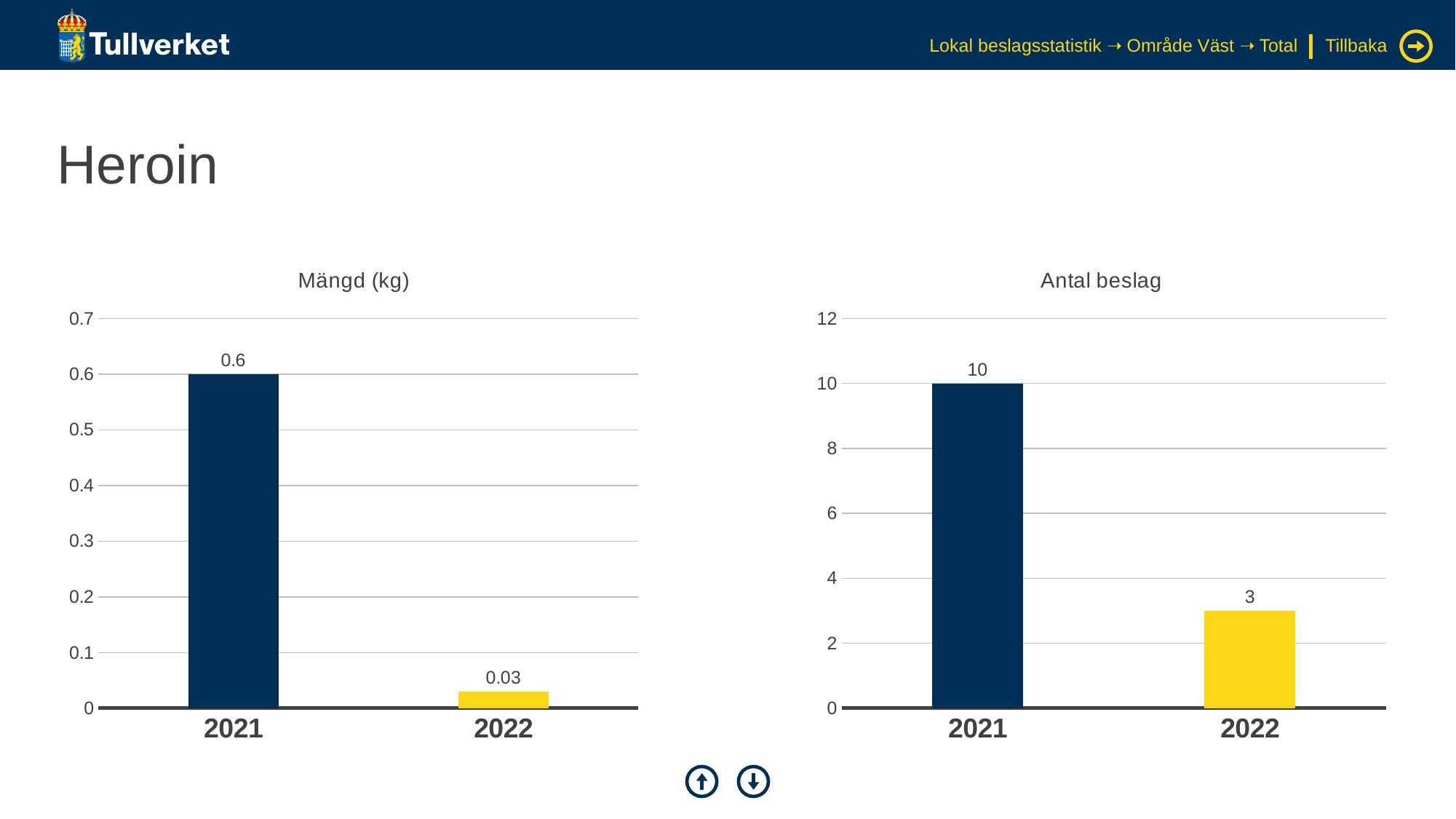
In the 'Antal beslag' chart, what is the value for 2022? 3 In the 'Mängd (kg)' chart, what is the difference between the 2021 and 2022 values? 0.57 In the 'Mängd (kg)' chart, what is the value for 2022? 0.03 In the 'Mängd (kg)' chart, is the value for 2021 larger or smaller than the value for 2022? larger In the 'Antal beslag' chart, which year has the highest value? 2021 In the 'Antal beslag' chart, do the values rise or fall from 2021 to 2022? fall In the 'Antal beslag' chart, what is the difference between the 2021 and 2022 values? 7 In the 'Mängd (kg)' chart, which year has the lowest value? 2022 What kind of chart is the 'Mängd (kg)' chart? bar chart In the 'Mängd (kg)' chart, what is the value for 2021? 0.6 In the 'Antal beslag' chart, what is the value for 2021? 10 How many categories are shown on the x axis of the 'Antal beslag' chart? 2